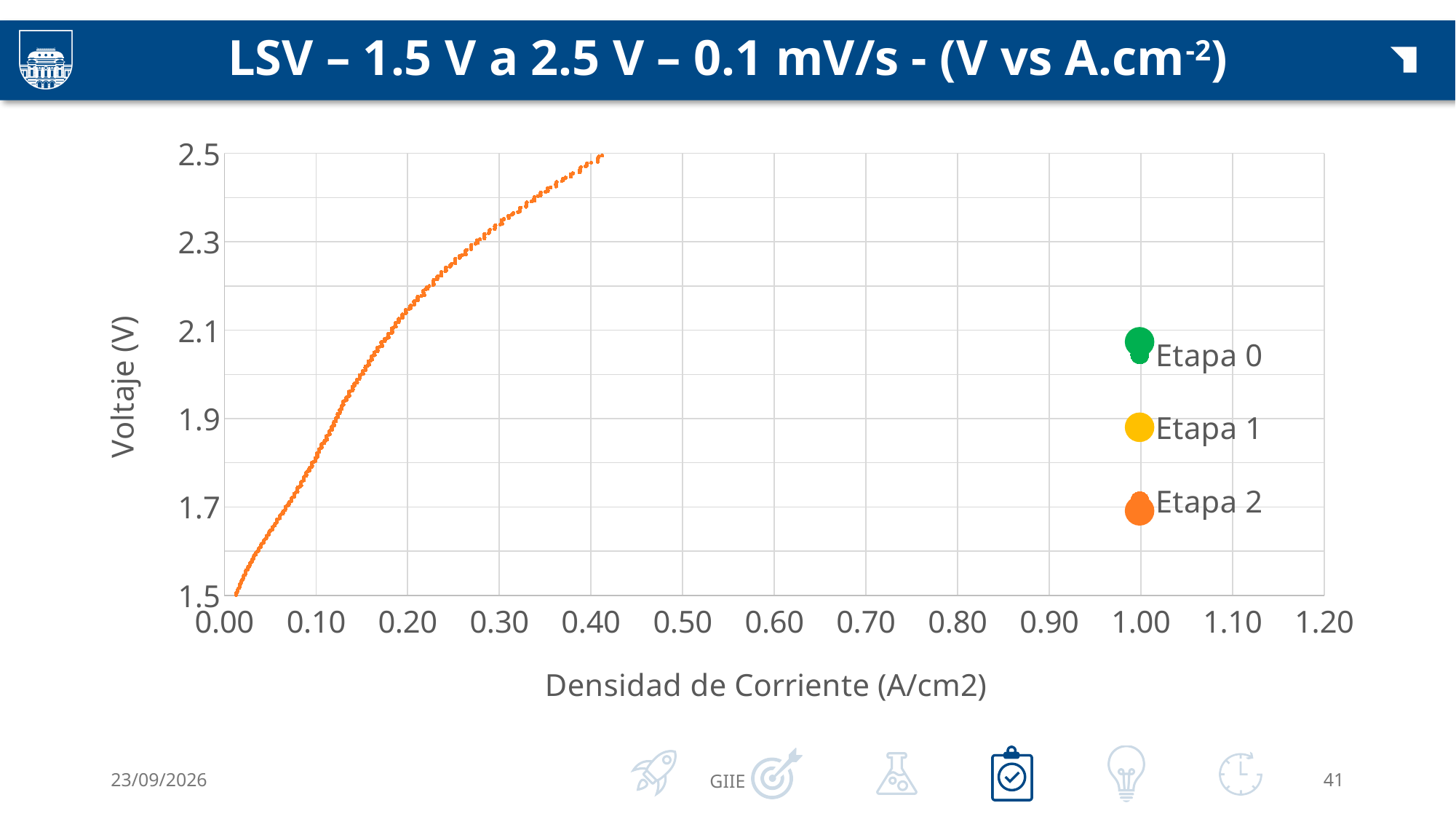
Is the voltage at a current density of 0.05 A/cm2 greater or less than 1.9 V? less Which legend entry is shown in orange? Etapa 2 Is the voltage at a current density of 0.40 A/cm2 greater or less than 2.3 V? greater Is the highest current density reached by the plotted data greater or less than 0.50 A/cm2? less What kind of chart is shown on the slide? Scatter chart Does the voltage rise or fall as current density increases along the x axis? Rises What is the title of the y axis? Voltaje (V) How many series does the legend list? 3